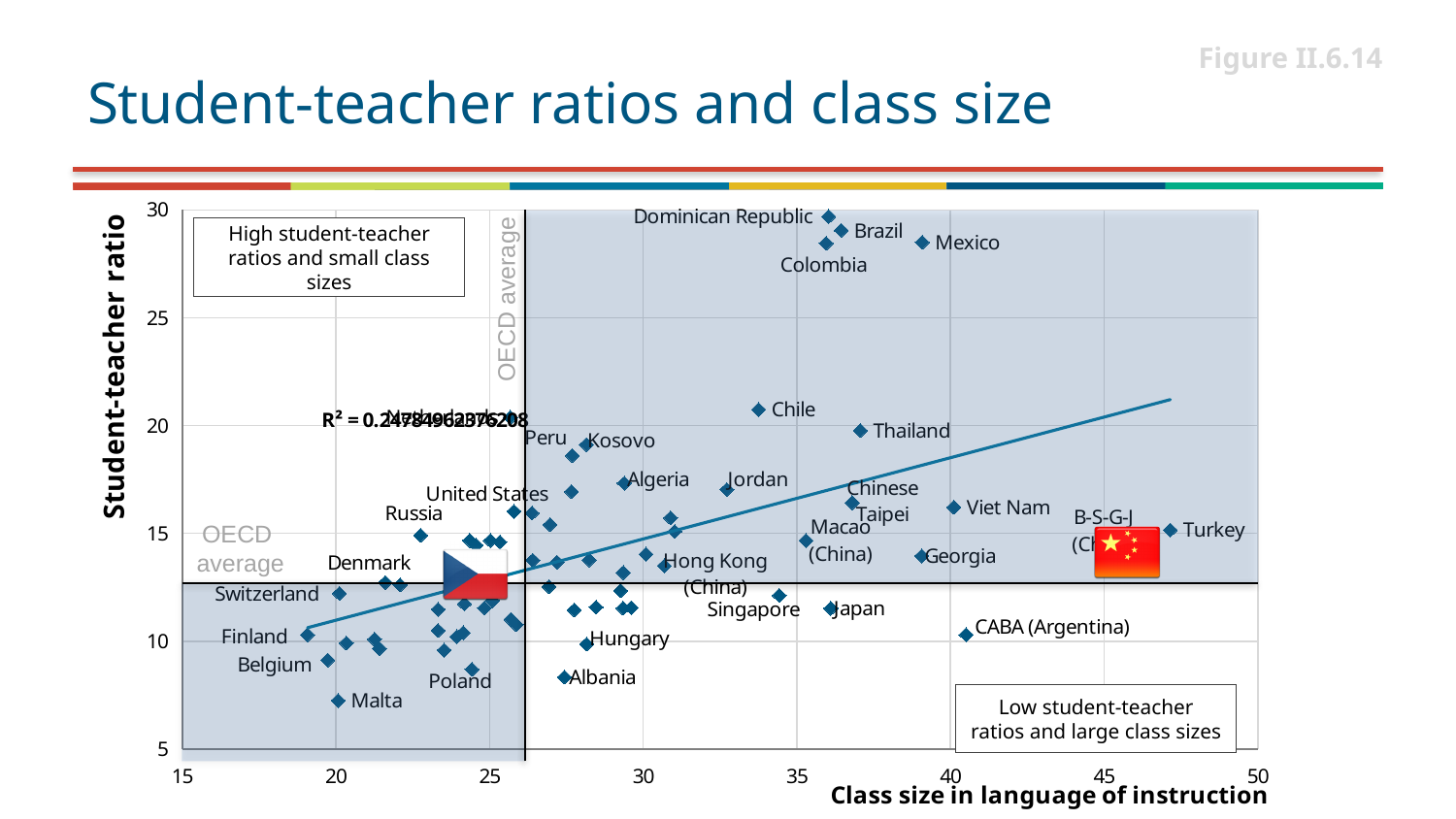
What kind of chart is shown on the slide? Scatter chart Which country has the lowest student-teacher ratio? Malta Is the student-teacher ratio for Mexico greater or less than 25? greater Is the class size for Viet Nam greater or less than 35? greater What is the title of the y axis? Student-teacher ratio Which country has the smallest class size in language of instruction? Finland What is the title of the x axis? Class size in language of instruction Is the student-teacher ratio for Malta greater or less than 10? less Which country has the largest class size in language of instruction? Turkey Does the trend line show student-teacher ratio rising or falling as class size increases? Rising Which has the higher student-teacher ratio, Mexico or Chile? Mexico